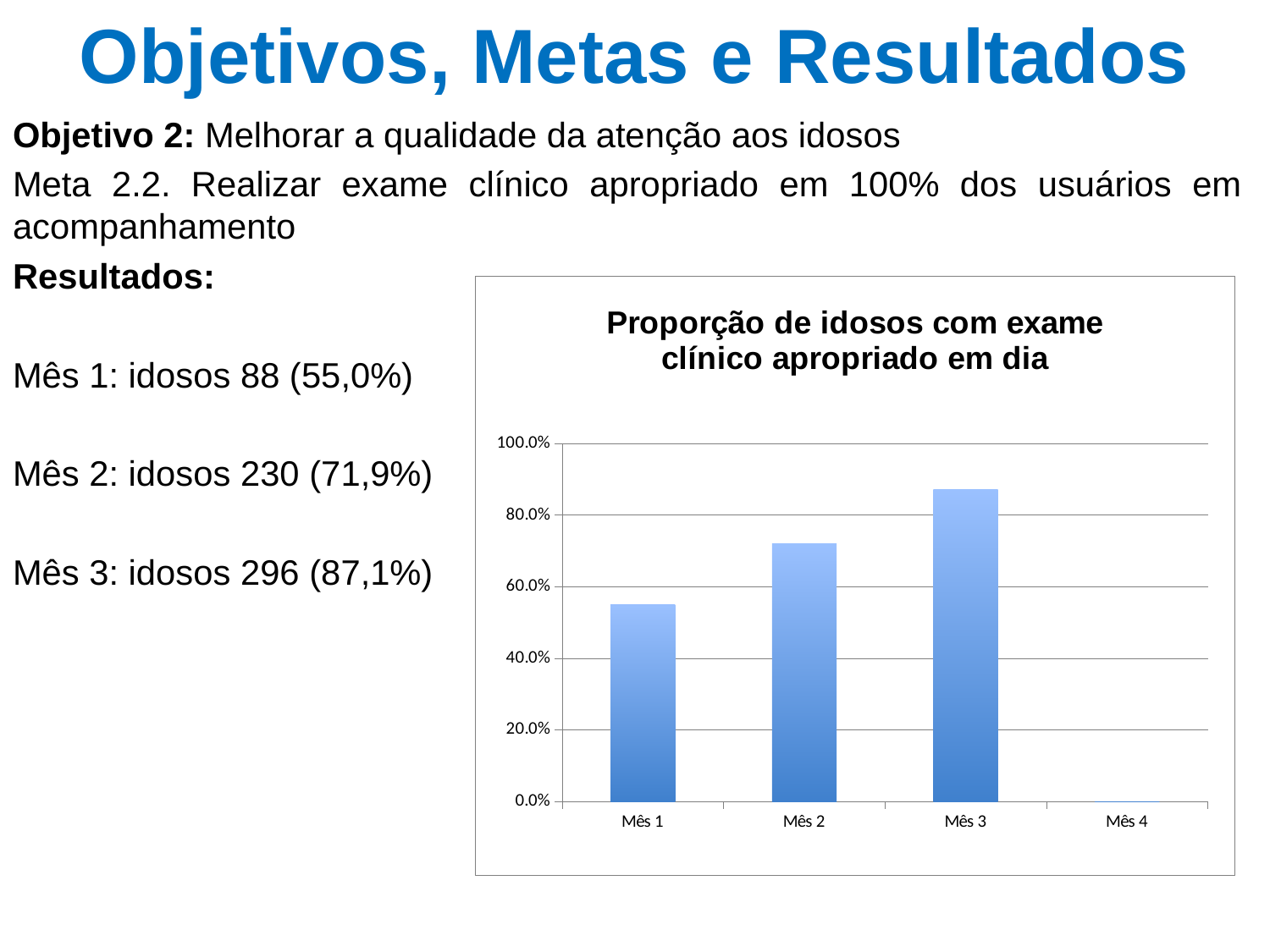
Which is larger, the value for Mês 2 or the value for Mês 3? Mês 3 What kind of chart is shown on the slide? bar chart According to the slide, what proportion of idosos had an appropriate clinical exam in Mês 3? 87,1% Is the value for Mês 3 greater or less than 80.0%? greater Is the value for Mês 2 greater or less than 60.0%? greater How many bars are plotted in the chart? 3 What is the title of the chart? Proporção de idosos com exame clínico apropriado em dia Which month has the lowest plotted bar in the chart? Mês 1 How many categories are shown on the x axis of the chart? 4 Which month has the highest bar in the chart? Mês 3 Do the values rise or fall from Mês 1 to Mês 3? rise Is the value for Mês 1 greater or less than 60.0%? less